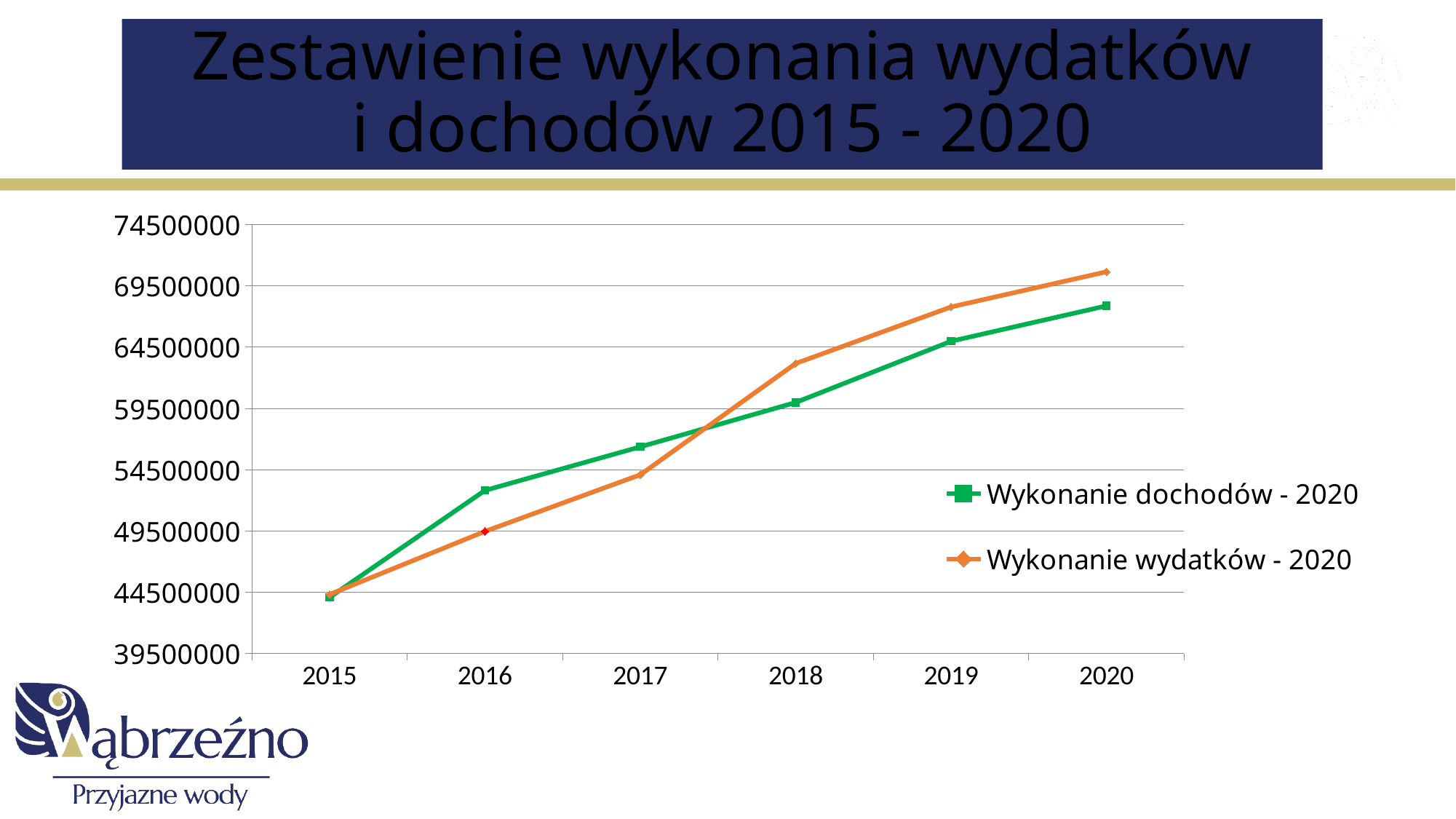
In which year is the value for Wykonanie wydatków - 2020 highest? 2020 Do the values for Wykonanie dochodów - 2020 rise or fall from 2015 to 2020? rise Is the value for Wykonanie dochodów - 2020 in 2020 greater or less than 69500000? less What colour is the line for Wykonanie wydatków - 2020? orange In 2019, which series has the larger value, Wykonanie dochodów - 2020 or Wykonanie wydatków - 2020? Wykonanie wydatków - 2020 How many series does the legend list? 2 How many years are plotted along the x axis? 6 What kind of chart is shown on the slide? line chart In 2016, which series has the larger value, Wykonanie dochodów - 2020 or Wykonanie wydatków - 2020? Wykonanie dochodów - 2020 In which year is the value for Wykonanie dochodów - 2020 lowest? 2015 Is the value for Wykonanie wydatków - 2020 in 2018 greater or less than 59500000? greater Is the value for Wykonanie dochodów - 2020 in 2016 greater or less than 49500000? greater